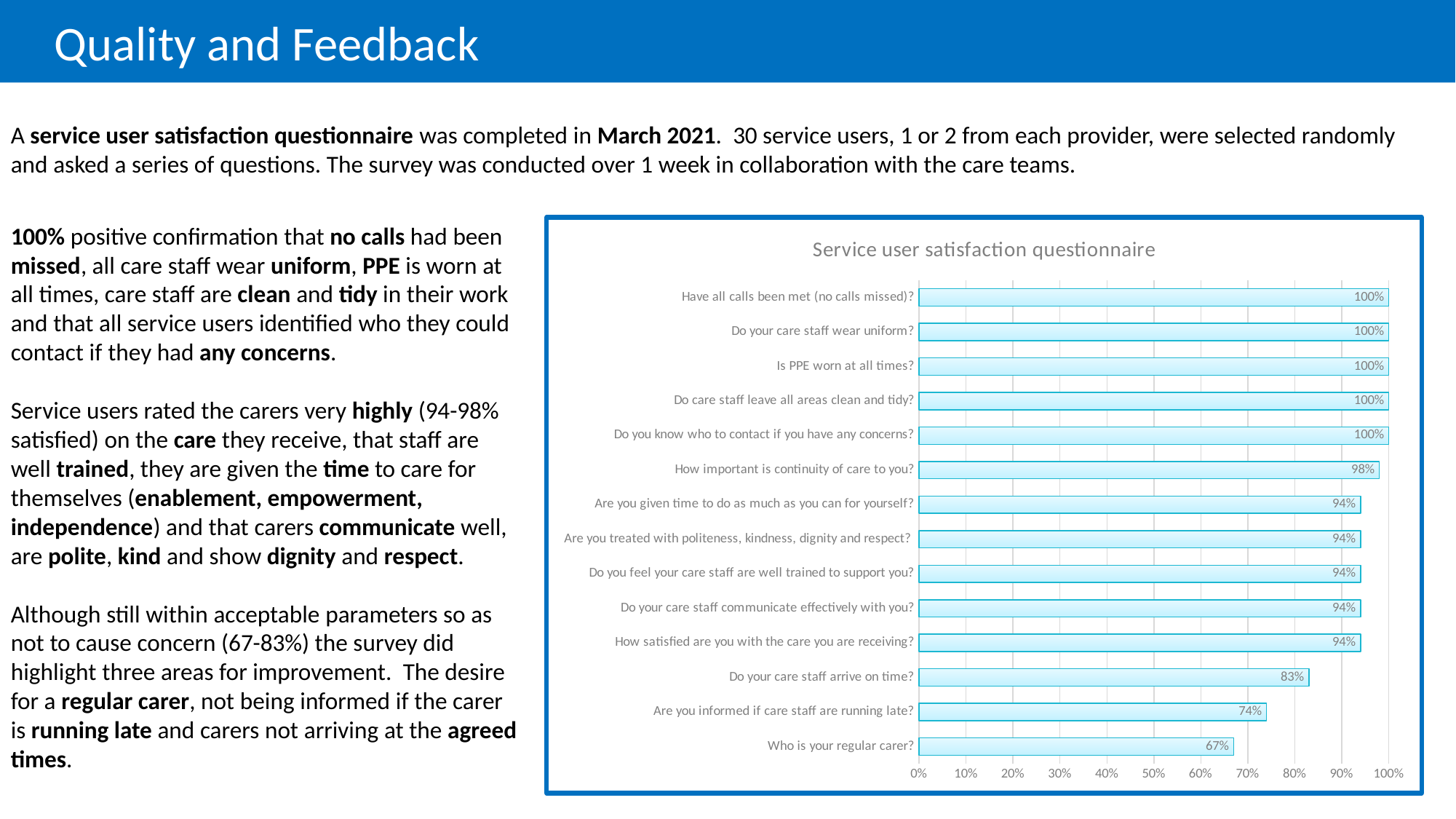
Which is larger: the value for "Are you informed if care staff are running late?" or the value for "Do your care staff arrive on time?"? Do your care staff arrive on time? Is the value for "Who is your regular carer?" greater or less than 70%? less Which category has the lowest value? Who is your regular carer? What is the value for "Are you informed if care staff are running late?"? 74% What is the difference between the values for "How important is continuity of care to you?" and "How satisfied are you with the care you are receiving?"? 4% What is the value for "Do your care staff arrive on time?"? 83% What is the difference between the values for "Do your care staff arrive on time?" and "Who is your regular carer?"? 16% What kind of chart is shown on the slide? Bar chart What is the title of the chart? Service user satisfaction questionnaire How many categories (questions) are shown in the chart? 14 What is the value for "Who is your regular carer?"? 67% What is the value for "How important is continuity of care to you?"? 98%